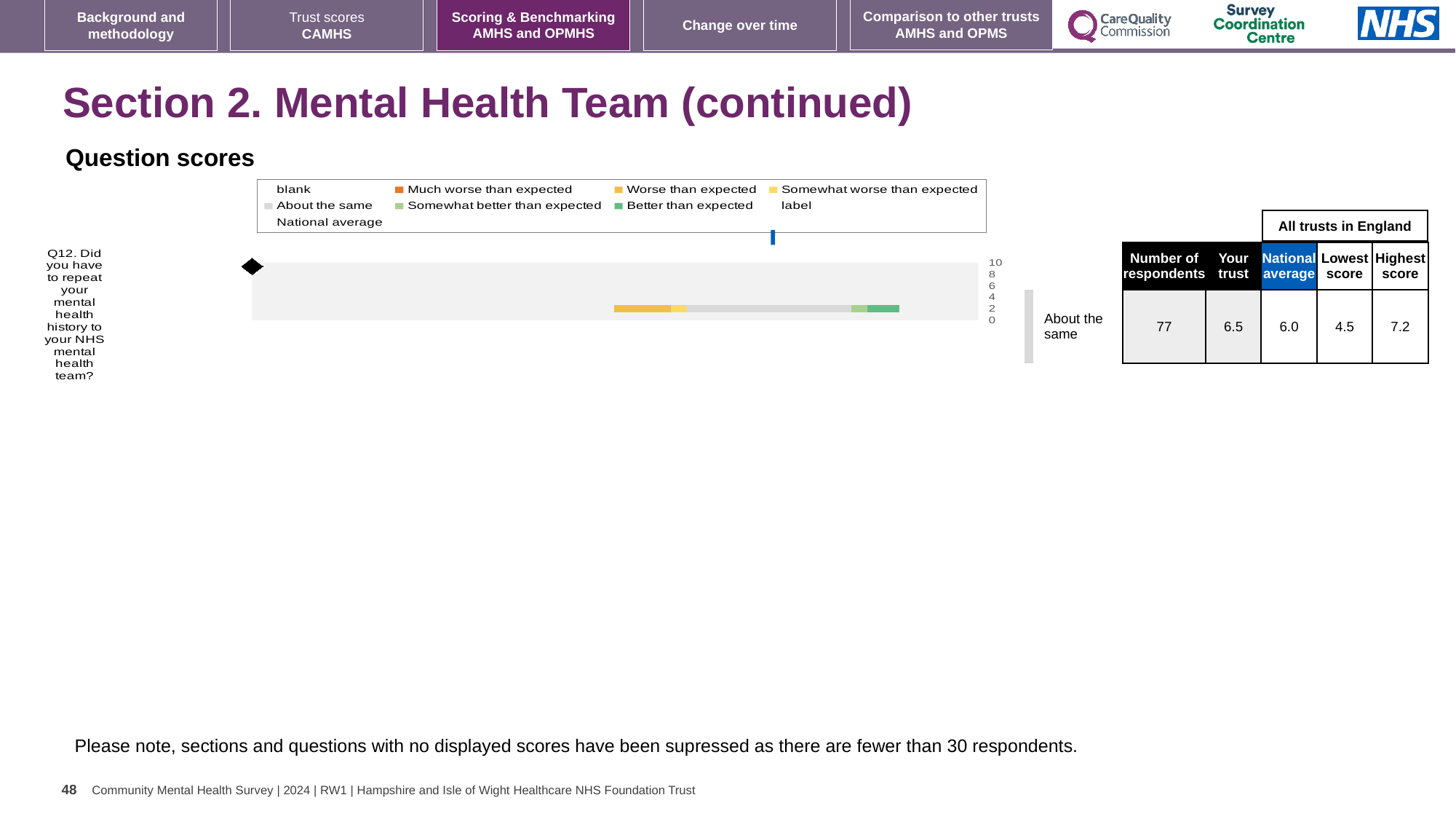
For Q12, what is the difference between the Highest score and the Lowest score in the table? 2.7 What kind of chart is shown under 'Question scores'? bar chart In the table beside the chart, what is the Highest score among all trusts in England for Q12? 7.2 How many entries does the legend of the Question scores chart list? 9 For Q12, which is larger: the 'Your trust' score or the National average? Your trust In the table beside the chart, what is the Lowest score among all trusts in England for Q12? 4.5 In the table beside the chart, how many respondents answered Q12? 77 In the table beside the chart, what is the 'Your trust' score for Q12? 6.5 Which question is plotted in the Question scores chart? Q12. Did you have to repeat your mental health history to your NHS mental health team? In the table beside the chart, what is the National average score for Q12? 6.0 What benchmark category is shown next to the bar for Q12? About the same How many questions (categories) are plotted in the Question scores chart? 1